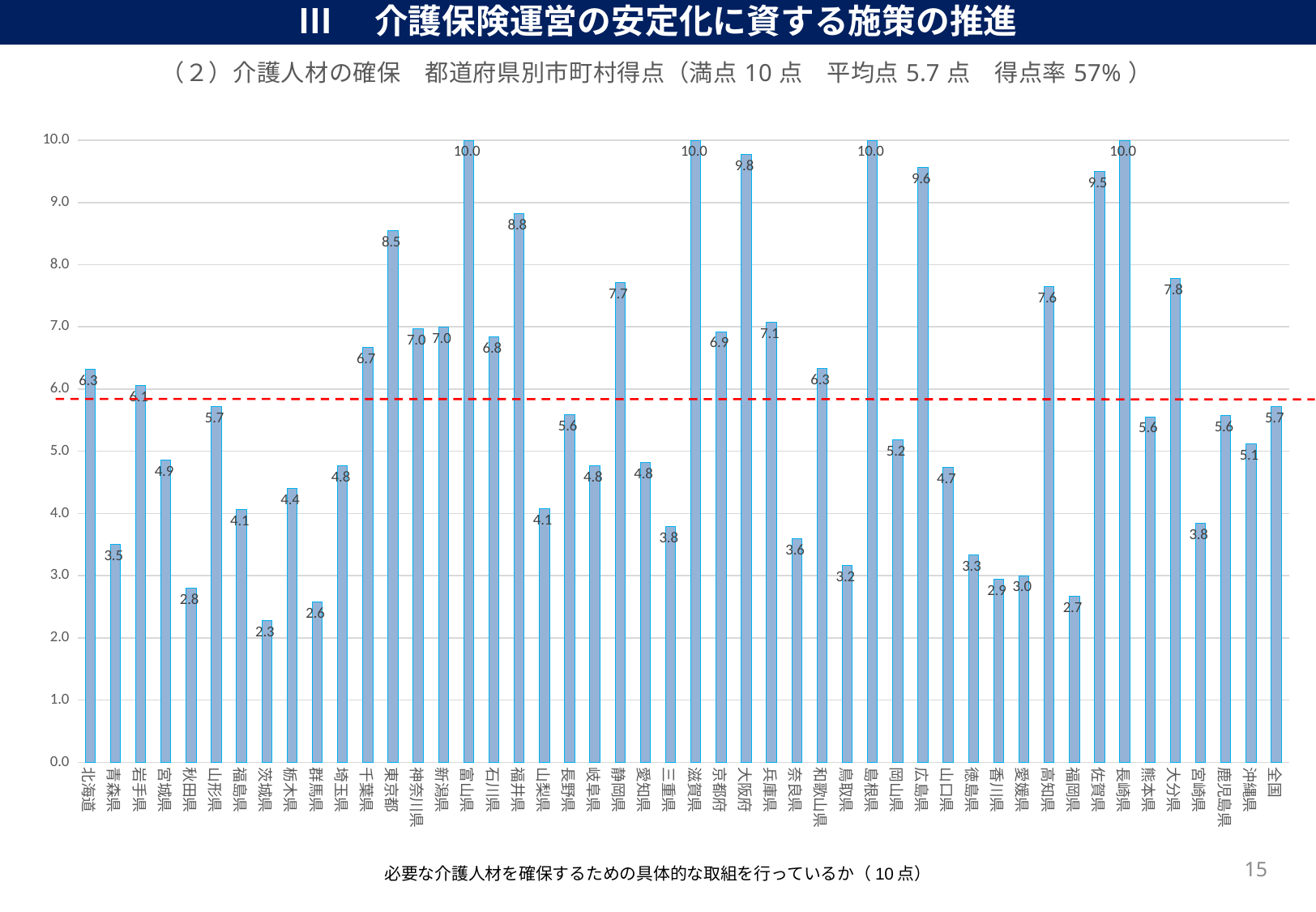
Which has a larger value, 広島県 or 佐賀県? 広島県 What is the value for 茨城県? 2.3 What is the value for 大阪府? 9.8 Is the value for 静岡県 greater or less than 7.0? greater What is the value for 東京都? 8.5 What kind of chart is shown on the slide? bar chart Which category has the lowest value? 茨城県 Which has a larger value, 秋田県 or 福岡県? 秋田県 What is the value for 全国? 5.7 What is the difference between the values for 福井県 and 山梨県? 4.7 What is the average score stated in the chart subtitle? 5.7 点 How many bars are plotted in the chart? 48